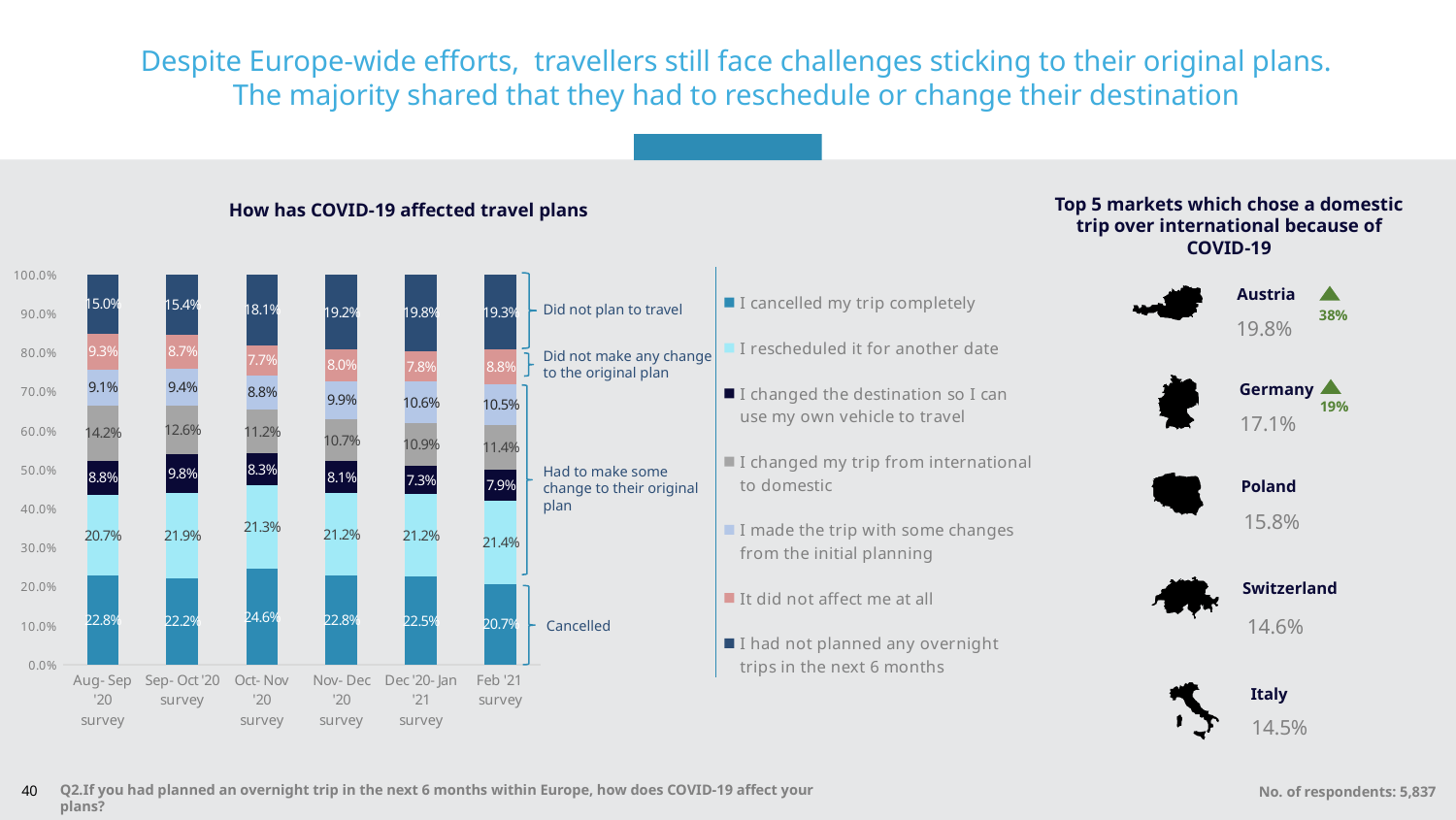
In the 'How has COVID-19 affected travel plans' chart, which survey wave has the lowest share for 'I cancelled my trip completely'? Feb '21 survey In the 'How has COVID-19 affected travel plans' chart, which survey wave has the highest share for 'I cancelled my trip completely'? Oct-Nov '20 survey In the Dec '20-Jan '21 survey of the 'How has COVID-19 affected travel plans' chart, which is larger: 'I made the trip with some changes from the initial planning' or 'I changed the destination so I can use my own vehicle to travel'? I made the trip with some changes from the initial planning In the 'How has COVID-19 affected travel plans' chart, what is the value for 'I rescheduled it for another date' in the Sep-Oct '20 survey? 21.9% What kind of chart is 'How has COVID-19 affected travel plans'? Stacked bar chart In the 'How has COVID-19 affected travel plans' chart, what share of respondents in the Oct-Nov '20 survey said 'I cancelled my trip completely'? 24.6% In the 'How has COVID-19 affected travel plans' chart, what is the value for 'I had not planned any overnight trips in the next 6 months' in the Feb '21 survey? 19.3% In the 'How has COVID-19 affected travel plans' chart, by how many percentage points did 'I changed my trip from international to domestic' fall from the Aug-Sep '20 survey to the Feb '21 survey? 2.8 percentage points In the 'How has COVID-19 affected travel plans' chart, does the share for 'I had not planned any overnight trips in the next 6 months' rise or fall from the Aug-Sep '20 survey to the Dec '20-Jan '21 survey? Rise How many survey waves are shown on the x axis of the 'How has COVID-19 affected travel plans' chart? 6 What is the title of the stacked bar chart on the slide? How has COVID-19 affected travel plans How many series does the legend of the 'How has COVID-19 affected travel plans' chart list? 7